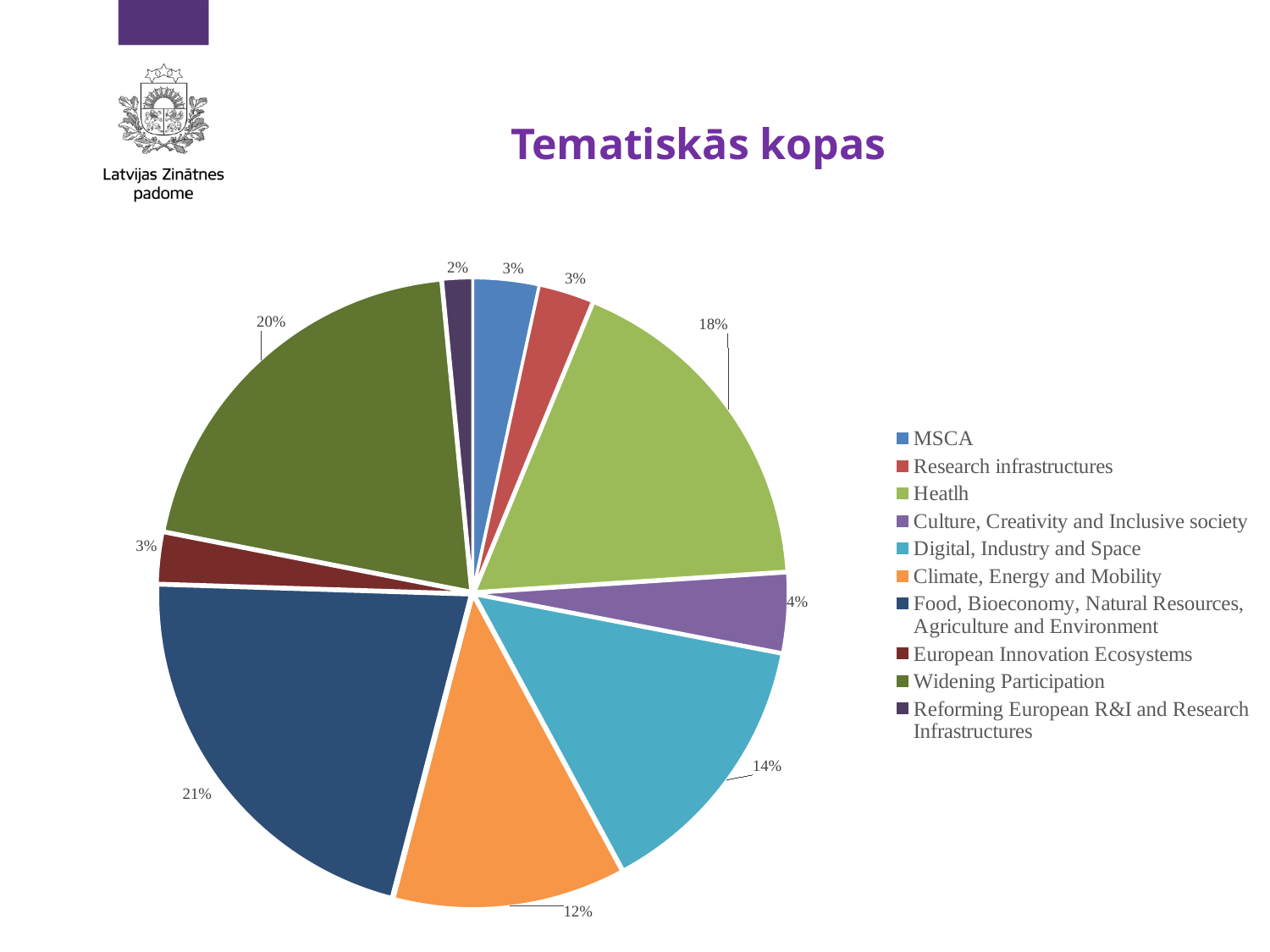
What percentage is shown for Widening Participation? 20% Which category has the smallest slice of the pie? Reforming European R&I and Research Infrastructures What type of chart is shown on the slide? Pie chart Which category has the largest slice of the pie? Food, Bioeconomy, Natural Resources, Agriculture and Environment What colour is the slice for Climate, Energy and Mobility? Orange How many categories does the pie chart show? 10 What percentage is shown for Digital, Industry and Space? 14% What share of the pie does Heatlh represent? 18% Which is larger, Widening Participation or Climate, Energy and Mobility? Widening Participation What is the title of the chart? Tematiskās kopas What is the difference in percentage points between Heatlh and Digital, Industry and Space? 4 What is the value for Climate, Energy and Mobility? 12%